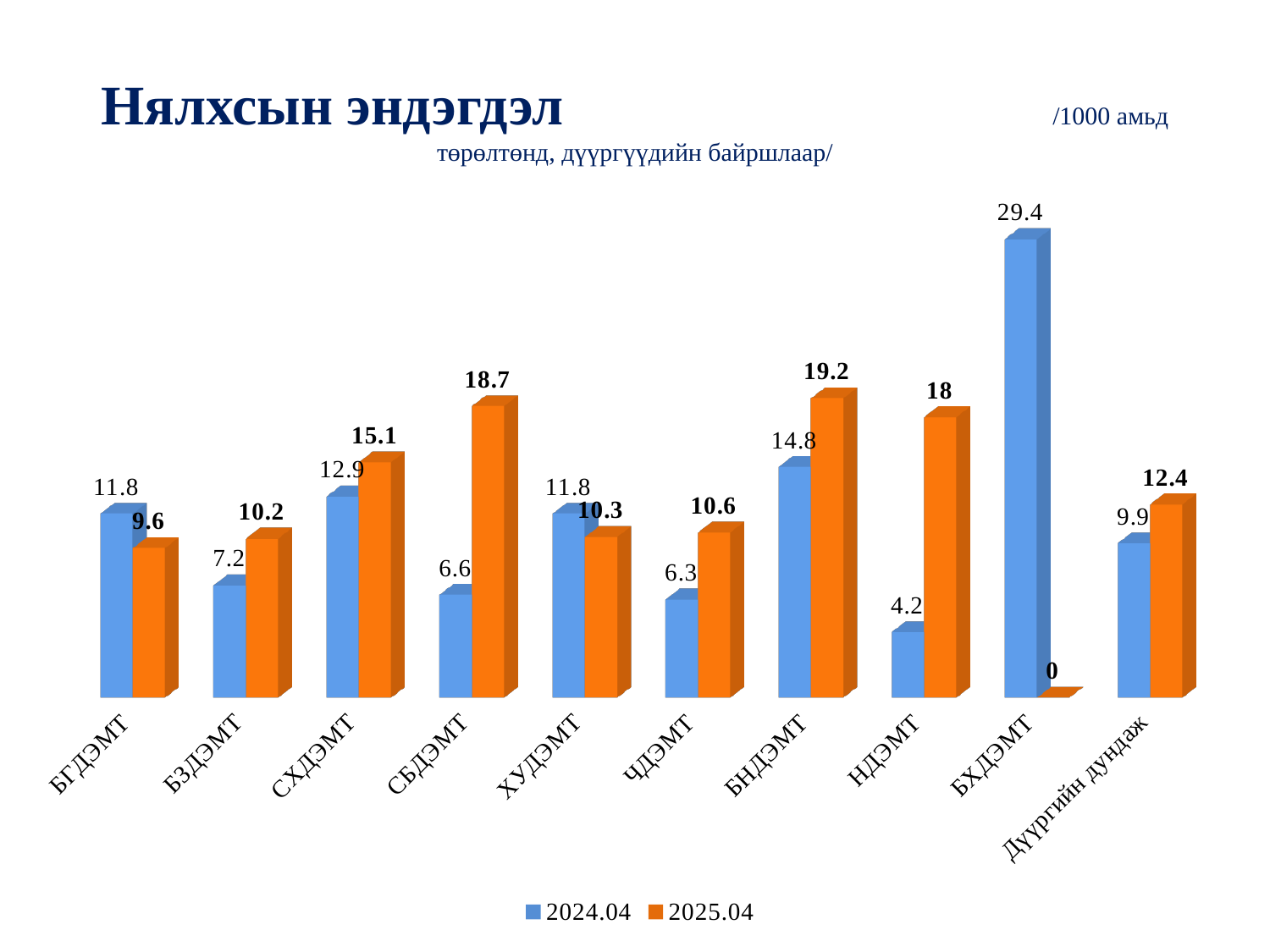
What is the 2024.04 value for НДЭМТ? 4.2 Which category has the highest 2025.04 value? БНДЭМТ What kind of chart is shown on the slide? Bar chart How many categories are shown on the x axis? 10 How many series does the legend list? 2 What is the 2025.04 value for СБДЭМТ? 18.7 What is the 2025.04 value for Дүүргийн дундаж? 12.4 What is the difference between the 2025.04 and 2024.04 values for НДЭМТ? 13.8 Which series is shown in orange? 2025.04 Which is larger for БГДЭМТ, the 2024.04 value or the 2025.04 value? 2024.04 Which category has the lowest 2025.04 value? БХДЭМТ Which category has the highest 2024.04 value? БХДЭМТ